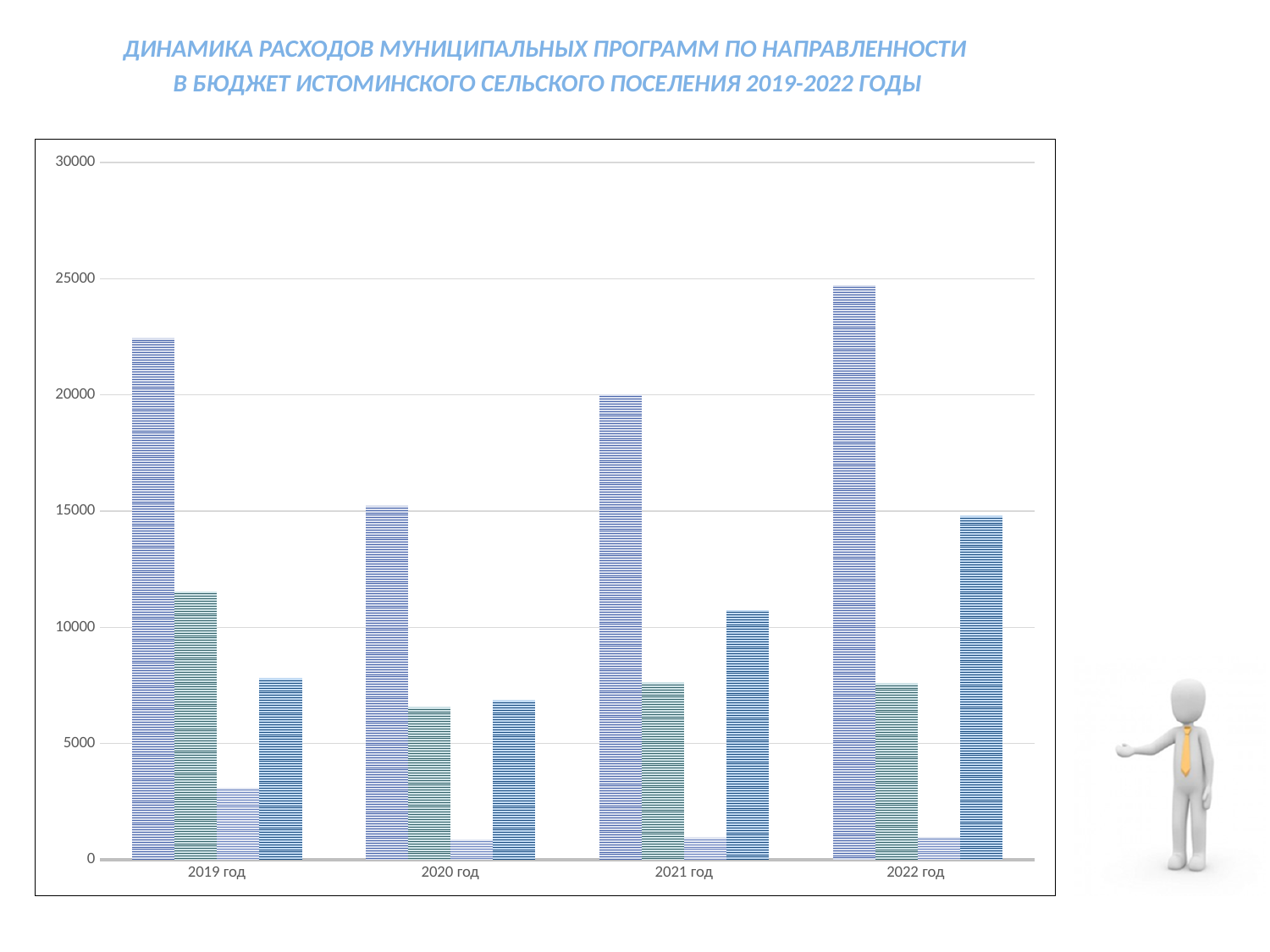
Is the value of the third (light blue) bar for 2019 год greater or less than 5000? less Is the value of the second (green) bar for 2019 год greater or less than 10000? greater Among the first bars of each year, which year has the lowest value? 2020 год Is the value of the tallest (first) bar for 2019 год greater or less than 20000? greater What kind of chart is shown on the slide? bar chart Does the fourth (dark blue) bar rise or fall from 2020 год to 2022 год? rises Which is larger: the first bar for 2021 год or the first bar for 2020 год? 2021 год How many bars are plotted for each year in the chart? 4 How many year categories are shown on the x axis of the chart? 4 Which year has the tallest bar in the chart? 2022 год